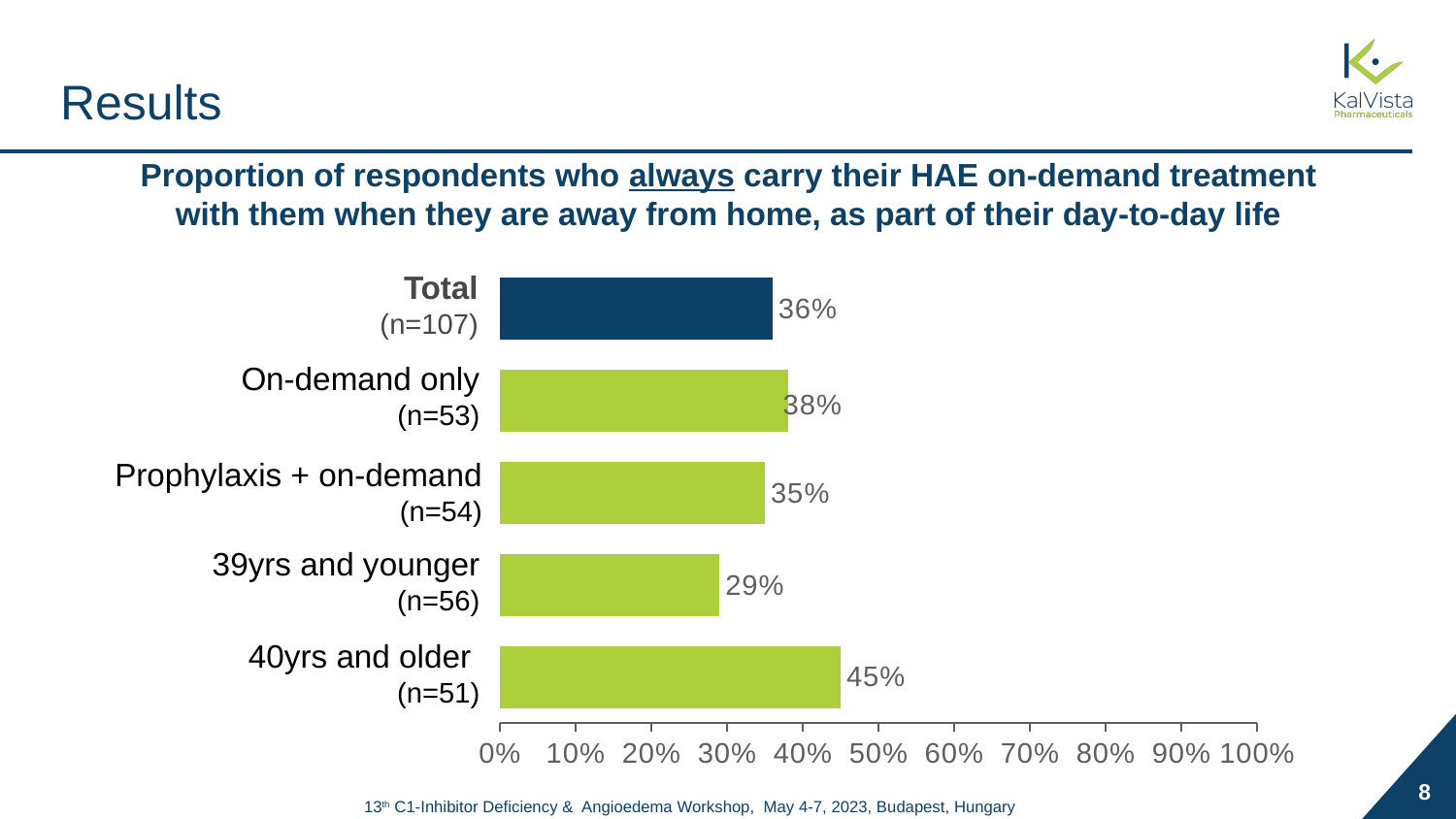
Which category has the highest value? 40yrs and older Which is larger, the value for On-demand only or the value for Prophylaxis + on-demand? On-demand only Which category has the lowest value? 39yrs and younger What is the value for Total (n=107)? 36% What is the difference between the values for 40yrs and older and 39yrs and younger? 16% What is the value for On-demand only (n=53)? 38% Is the value for 40yrs and older greater or less than 40%? greater How many categories are shown in the chart? 5 What is the value for 40yrs and older (n=51)? 45% What is the value for 39yrs and younger (n=56)? 29% What is the value for Prophylaxis + on-demand (n=54)? 35% What kind of chart is shown on the slide? Bar chart